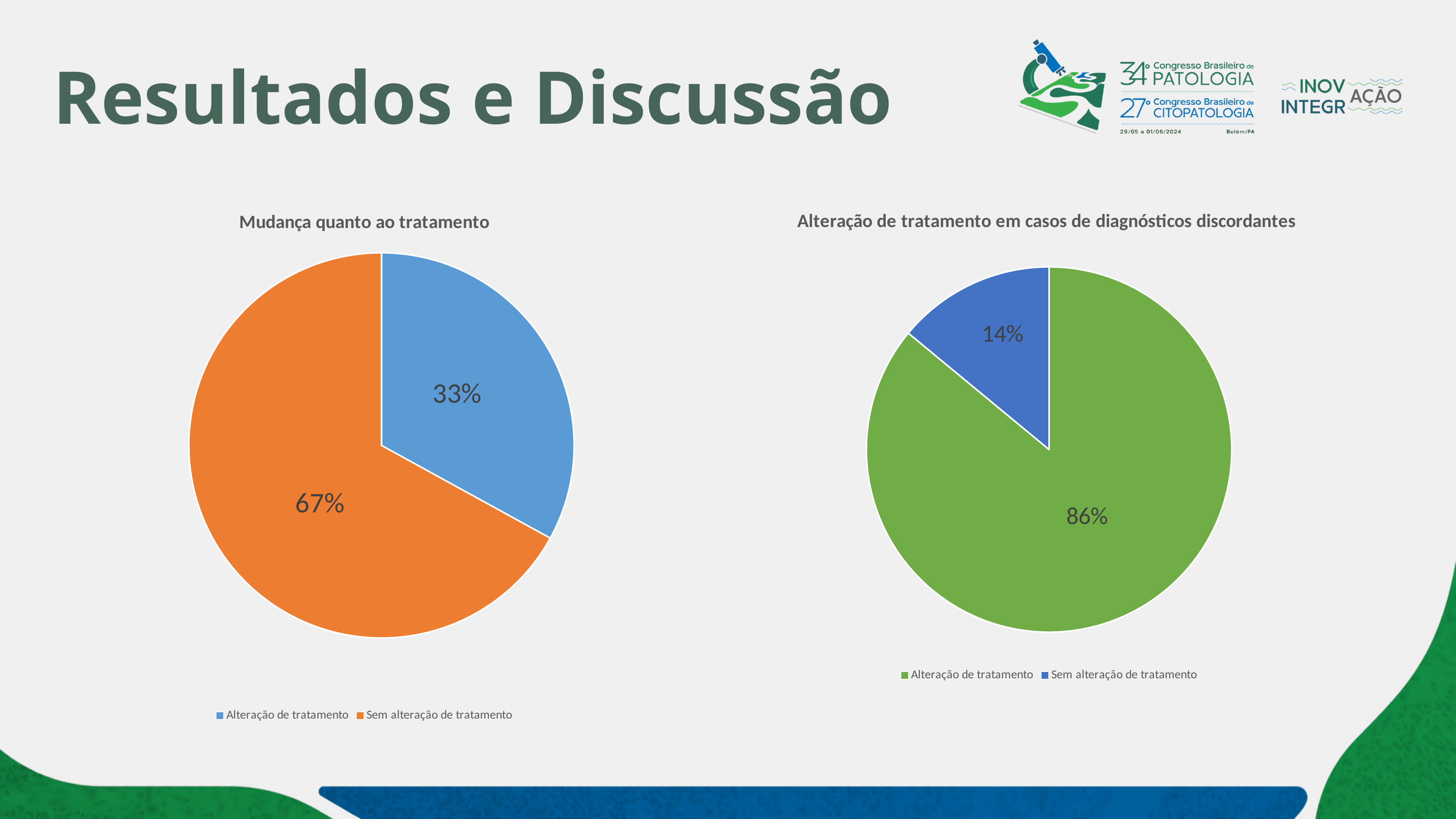
In the 'Alteração de tratamento em casos de diagnósticos discordantes' chart, what share is labelled for 'Sem alteração de tratamento'? 14% In the 'Mudança quanto ao tratamento' chart, what share is labelled for 'Sem alteração de tratamento'? 67% In the 'Alteração de tratamento em casos de diagnósticos discordantes' chart, which category has the smallest slice? Sem alteração de tratamento In the 'Mudança quanto ao tratamento' chart, what share is labelled for 'Alteração de tratamento'? 33% In the 'Mudança quanto ao tratamento' chart, which category has the largest slice? Sem alteração de tratamento In the 'Alteração de tratamento em casos de diagnósticos discordantes' chart, what colour is the 'Alteração de tratamento' slice? Green What type of chart is 'Mudança quanto ao tratamento'? Pie chart In the 'Mudança quanto ao tratamento' chart, what is the difference between the 'Sem alteração de tratamento' and 'Alteração de tratamento' shares? 34% Which is larger: the 'Alteração de tratamento' share in the left chart or the 'Alteração de tratamento' share in the right chart? The right chart (86%) In the 'Alteração de tratamento em casos de diagnósticos discordantes' chart, what is the difference between the 'Alteração de tratamento' and 'Sem alteração de tratamento' shares? 72% How many slices does the 'Alteração de tratamento em casos de diagnósticos discordantes' chart have? 2